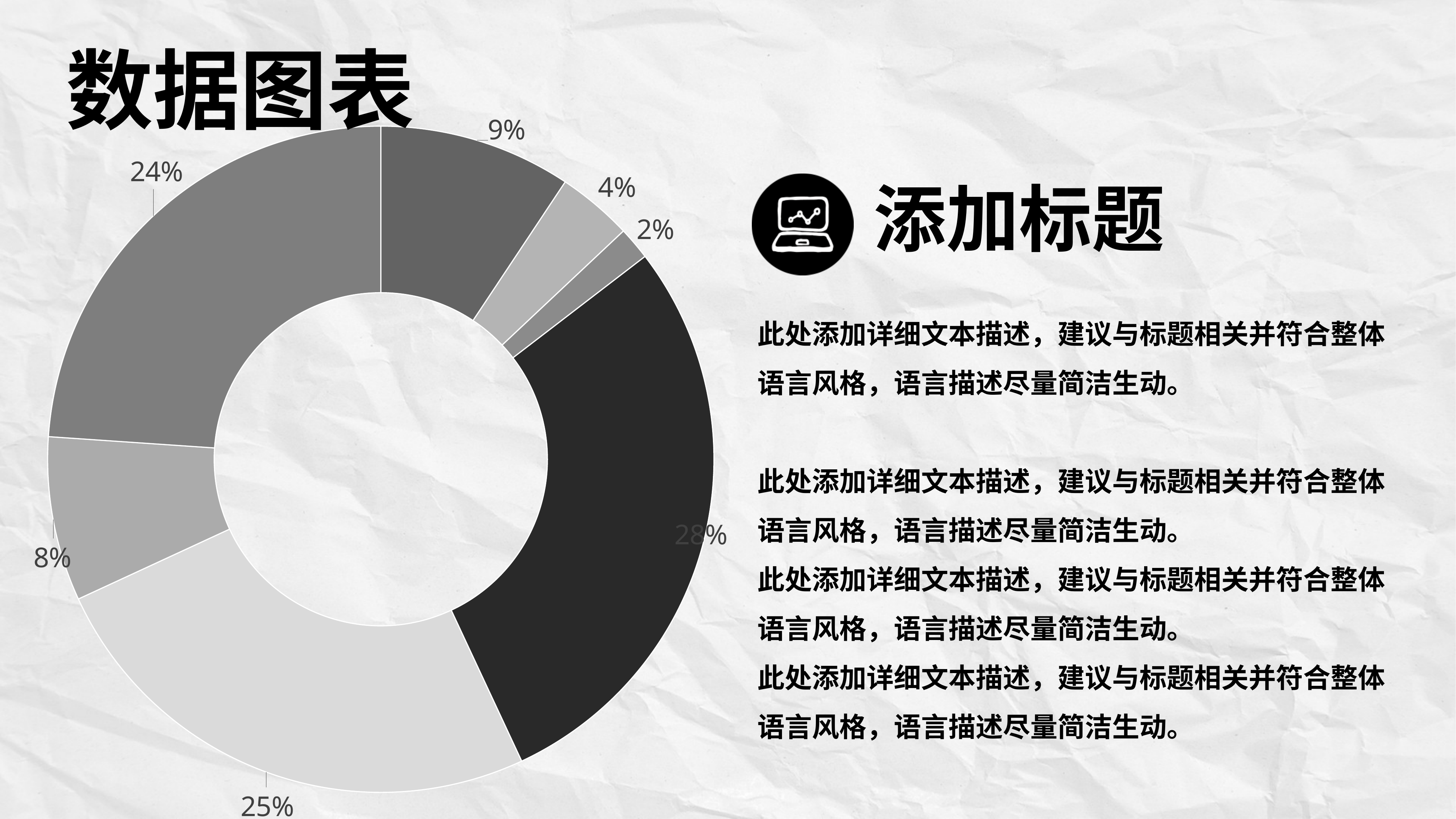
What is the difference between the 28% slice and the 25% slice? 3 percentage points What percentage is labelled on the slice at the top left of the doughnut chart? 24% What percentage is labelled on the slice at the left of the doughnut chart? 8% What kind of chart is shown on the slide? Doughnut (pie) chart What is the title of the slide containing the doughnut chart? 数据图表 What percentage is labelled on the black slice on the right side of the doughnut chart? 28% What percentage is labelled on the lightest slice at the bottom of the doughnut chart? 25% How many slices does the doughnut chart have? 7 What is the smallest percentage shown on the doughnut chart? 2% Which is larger, the slice labelled 24% or the slice labelled 25%? 25% What is the difference between the 9% slice and the 4% slice? 5 percentage points What is the largest percentage shown on the doughnut chart? 28%